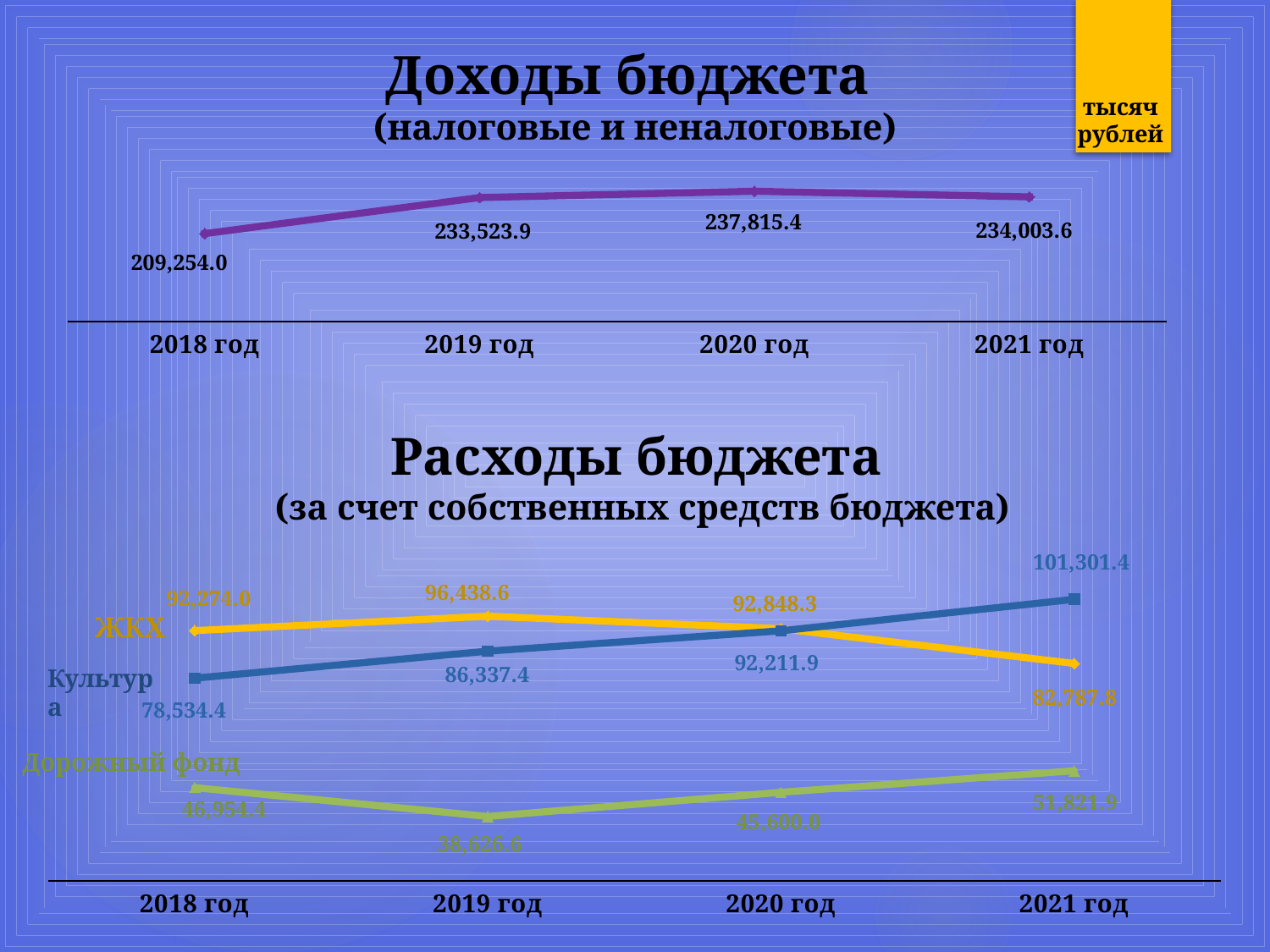
In the 'Расходы бюджета' chart, what is the value for Дорожный фонд in 2019 год? 38,626.6 In the 'Доходы бюджета' chart, what is the value for 2018 год? 209,254.0 In the 'Расходы бюджета' chart, how many series are plotted? 3 In the 'Расходы бюджета' chart, what is the value for Культура in 2021 год? 101,301.4 In the 'Доходы бюджета' chart, what is the difference between the 2020 год and 2019 год values? 4,291.5 In the 'Расходы бюджета' chart, what is the value for ЖКХ in 2019 год? 96,438.6 What type of chart is the 'Расходы бюджета' chart? Line chart In the 'Расходы бюджета' chart, does the Культура series rise or fall from 2018 год to 2021 год? Rises In the 'Доходы бюджета' chart, which year has the lowest value? 2018 год In the 'Доходы бюджета' chart, how many years are plotted? 4 In the 'Доходы бюджета' chart, which year has the highest value? 2020 год In the 'Расходы бюджета' chart, which is larger in 2021 год: ЖКХ or Культура? Культура